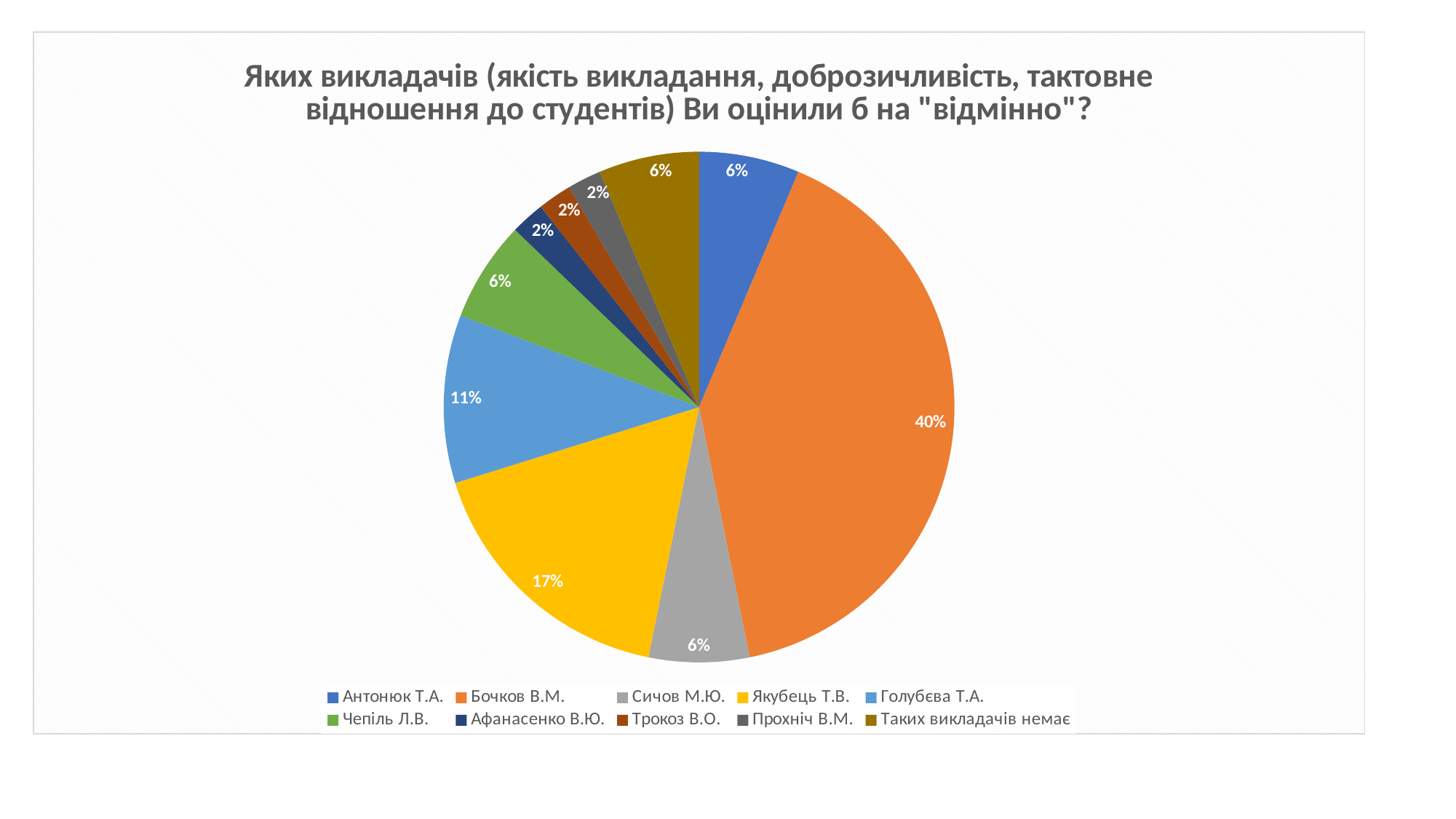
Which is larger, the share for Голубєва Т.А. or the share for Чепіль Л.В.? Голубєва Т.А. What share of the pie does the slice 'Таких викладачів немає' have? 6% What is the difference between the shares of Бочков В.М. and Якубець Т.В.? 23% What colour is the slice for Якубець Т.В.? yellow What share of the pie does Голубєва Т.А. have? 11% How many slices are labelled 2%? 3 What share of the pie does Якубець Т.В. have? 17% How many categories does the legend list? 10 What type of chart is shown on the slide? pie chart Which category has the largest slice of the pie? Бочков В.М.